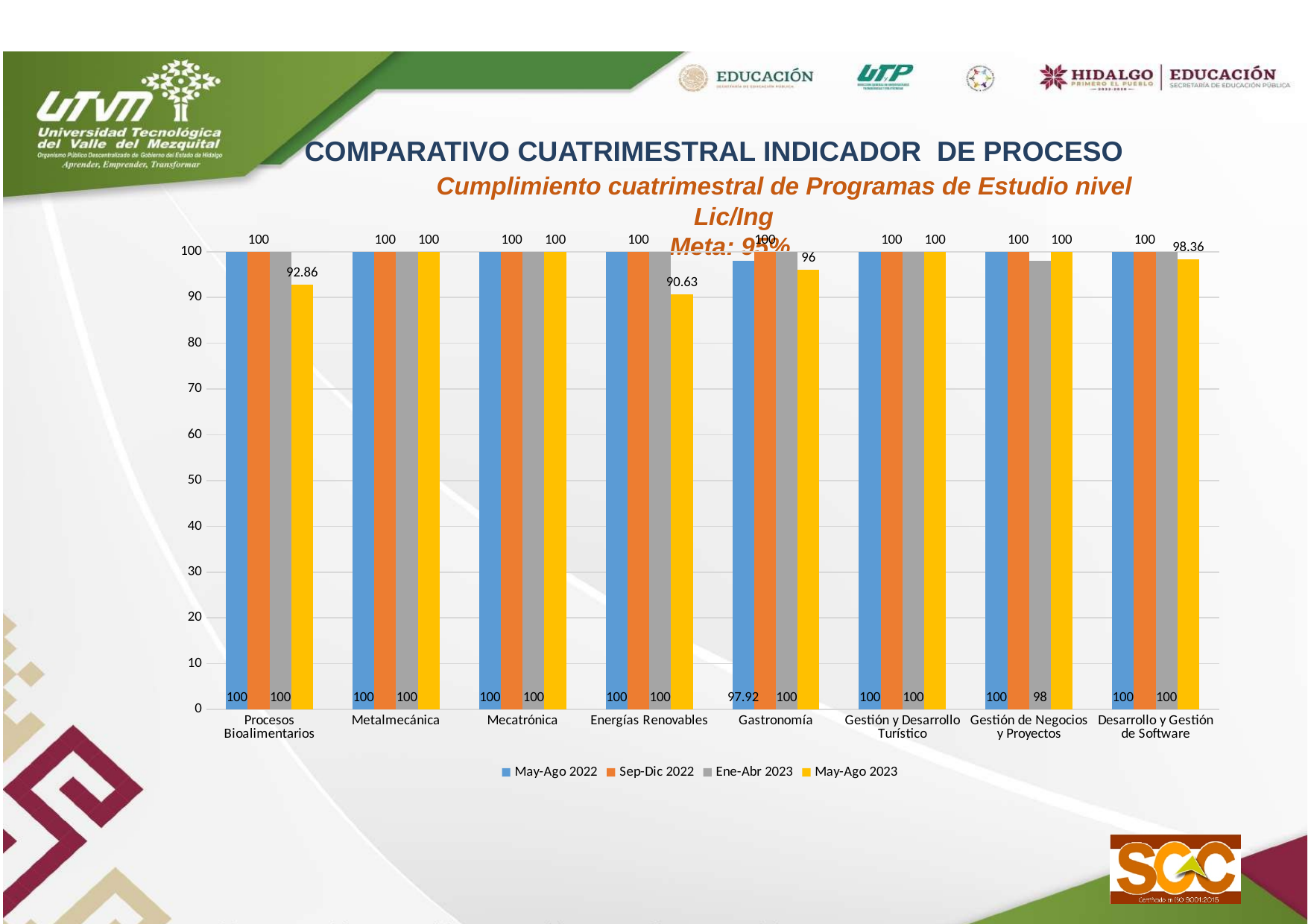
How many programs (categories) are shown on the x axis? 8 Which program has the lowest May-Ago 2023 value? Energías Renovables For Energías Renovables, what is the difference between the Ene-Abr 2023 value and the May-Ago 2023 value? 9.37 What is the May-Ago 2022 value for Gastronomía? 97.92 What kind of chart is shown on the slide? Bar chart How many series does the legend list? 4 What is the Ene-Abr 2023 value for Gestión de Negocios y Proyectos? 98 What is the May-Ago 2023 value for Procesos Bioalimentarios? 92.86 What is the May-Ago 2023 value for Desarrollo y Gestión de Software? 98.36 Which is larger: the May-Ago 2023 value for Gastronomía or the May-Ago 2023 value for Procesos Bioalimentarios? Gastronomía What is the May-Ago 2023 value for Energías Renovables? 90.63 What target (Meta) is stated on the chart? 95%